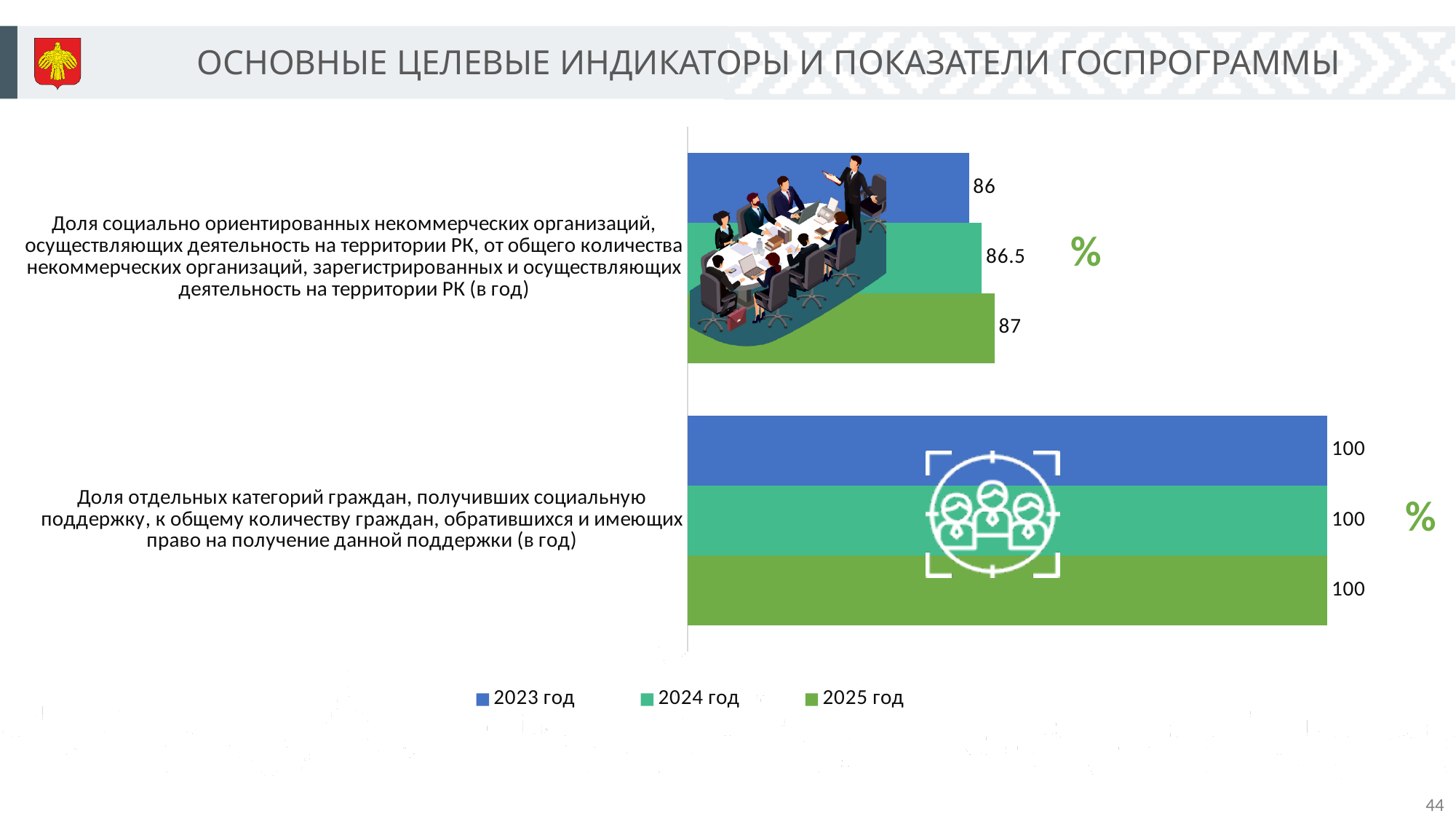
What is the value for 2023 год for the indicator 'Доля отдельных категорий граждан, получивших социальную поддержку...'? 100 Which year has the lowest value for the indicator 'Доля социально ориентированных некоммерческих организаций...'? 2023 год Which colour represents 2024 год in the legend? green (teal) What is the value for 2025 год for the indicator 'Доля отдельных категорий граждан, получивших социальную поддержку...'? 100 Which year has the highest value for the indicator 'Доля социально ориентированных некоммерческих организаций...'? 2025 год How many series does the legend list? 3 What kind of chart is shown on the slide? bar chart What is the value for 2025 год for the indicator 'Доля социально ориентированных некоммерческих организаций...'? 87 What is the difference between the 2025 год and 2023 год values for the indicator 'Доля социально ориентированных некоммерческих организаций...'? 1 What is the value for 2023 год for the indicator 'Доля социально ориентированных некоммерческих организаций...'? 86 What is the value for 2024 год for the indicator 'Доля социально ориентированных некоммерческих организаций...'? 86.5 Do the values for the indicator 'Доля социально ориентированных некоммерческих организаций...' rise or fall from 2023 год to 2025 год? rise